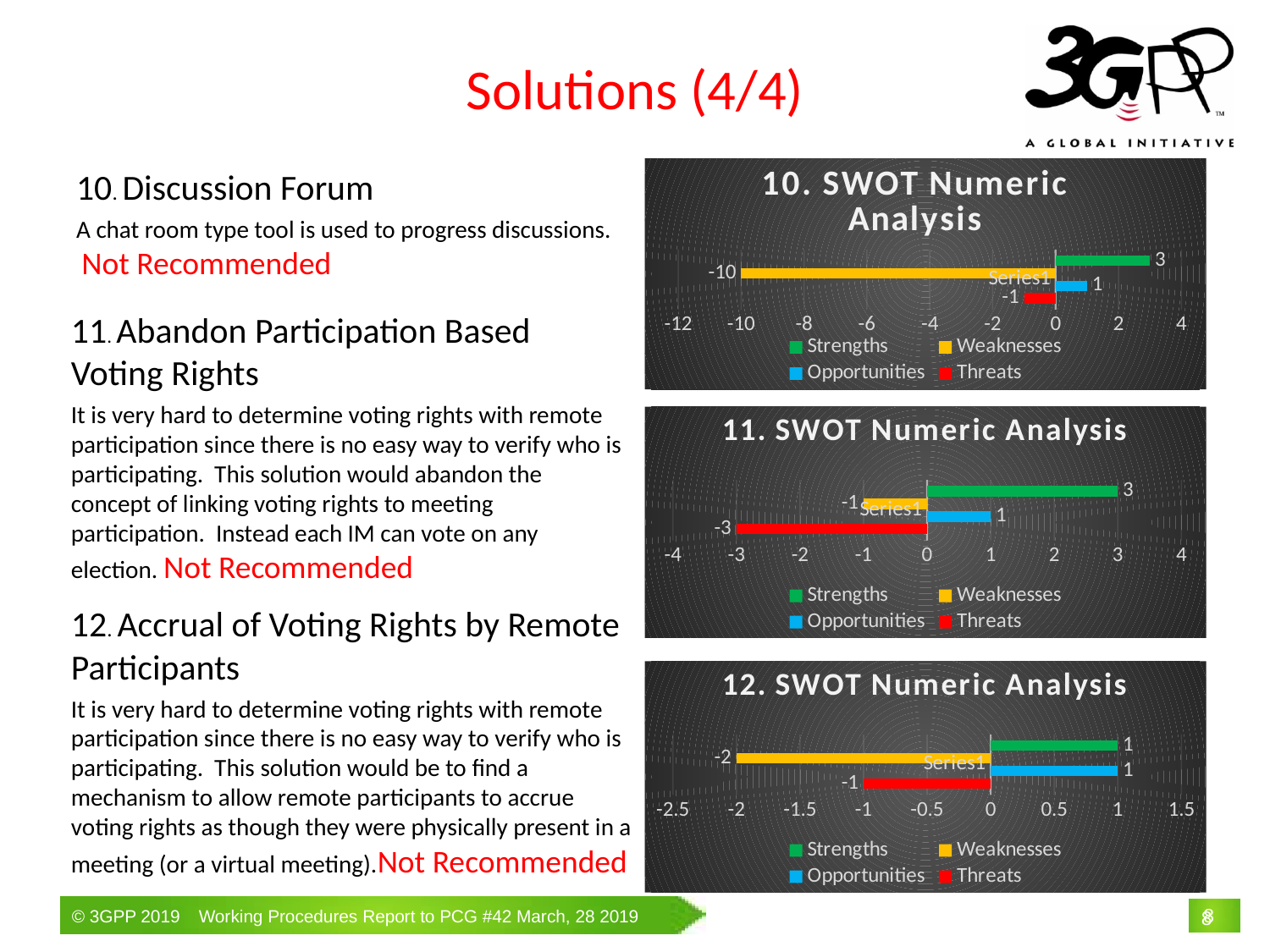
How many series does the legend of the chart titled "12. SWOT Numeric Analysis" list? 4 In the chart titled "10. SWOT Numeric Analysis", which series has the lowest value? Weaknesses In the chart titled "11. SWOT Numeric Analysis", what is the value for Threats? -3 In the chart titled "11. SWOT Numeric Analysis", which series has the highest value? Strengths In the chart titled "12. SWOT Numeric Analysis", what is the value for Weaknesses? -2 What kind of chart is the chart titled "10. SWOT Numeric Analysis"? Bar chart In the chart titled "12. SWOT Numeric Analysis", which is larger, the Strengths value or the Threats value? Strengths In the chart titled "11. SWOT Numeric Analysis", what is the difference between the Strengths value and the Opportunities value? 2 In the chart titled "11. SWOT Numeric Analysis", what is the value for Weaknesses? -1 In the chart titled "12. SWOT Numeric Analysis", what is the value for Threats? -1 In the chart titled "10. SWOT Numeric Analysis", what is the value for Weaknesses? -10 In the chart titled "10. SWOT Numeric Analysis", what is the value for Strengths? 3